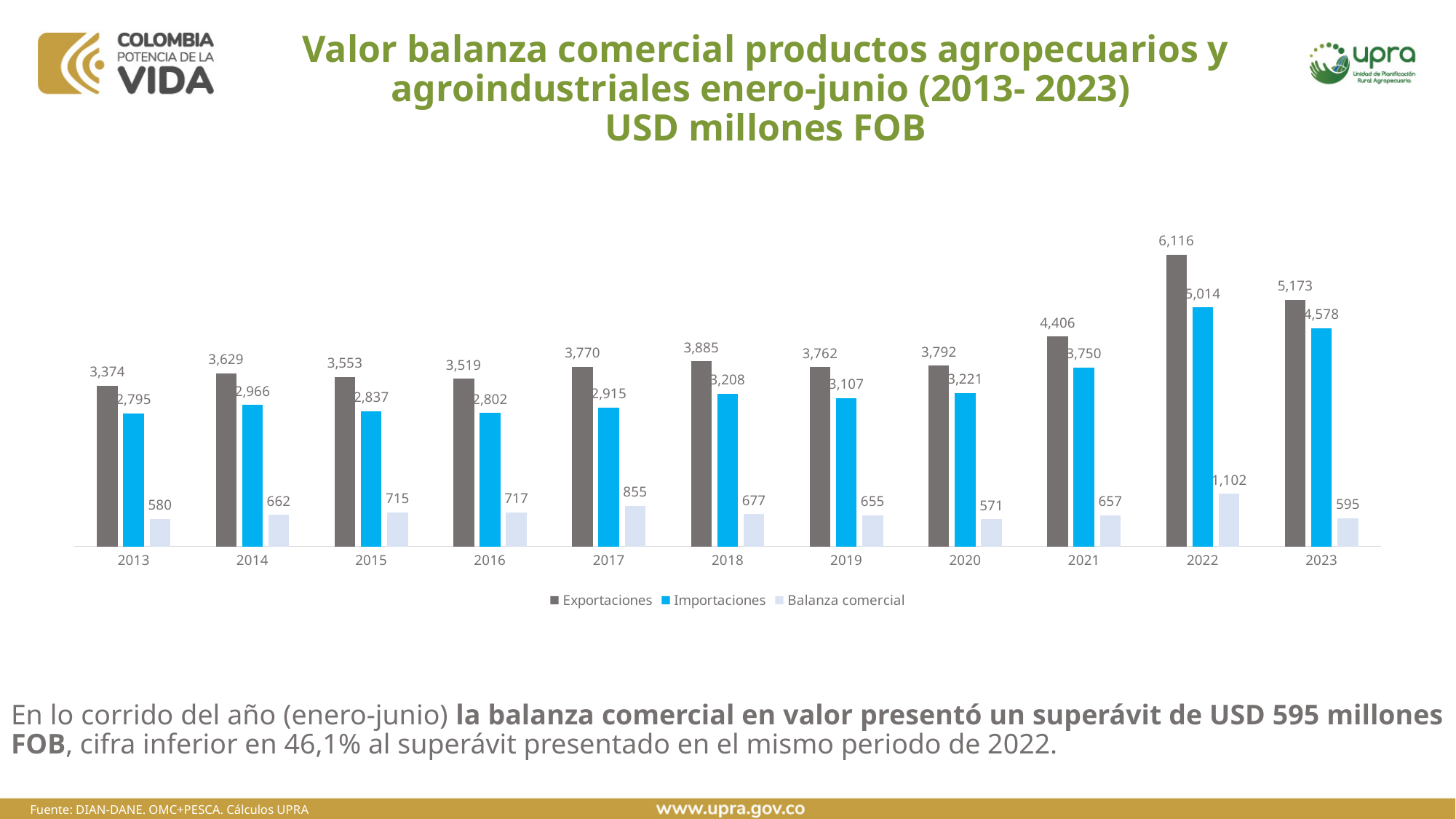
What is the value of Exportaciones for 2022? 6,116 Which year has the highest Exportaciones value? 2022 Which series is shown in blue in the legend? Importaciones How many years are shown on the x axis? 11 What is the value of Balanza comercial for 2017? 855 What is the value of Importaciones for 2019? 3,107 How many series does the legend list? 3 What is the difference between Exportaciones and Importaciones in 2023? 595 Which year has the lowest Balanza comercial value? 2020 Which is larger, Importaciones in 2021 or Importaciones in 2020? Importaciones in 2021 What kind of chart is shown on the slide? Bar chart Did Exportaciones rise or fall from 2022 to 2023? Fall